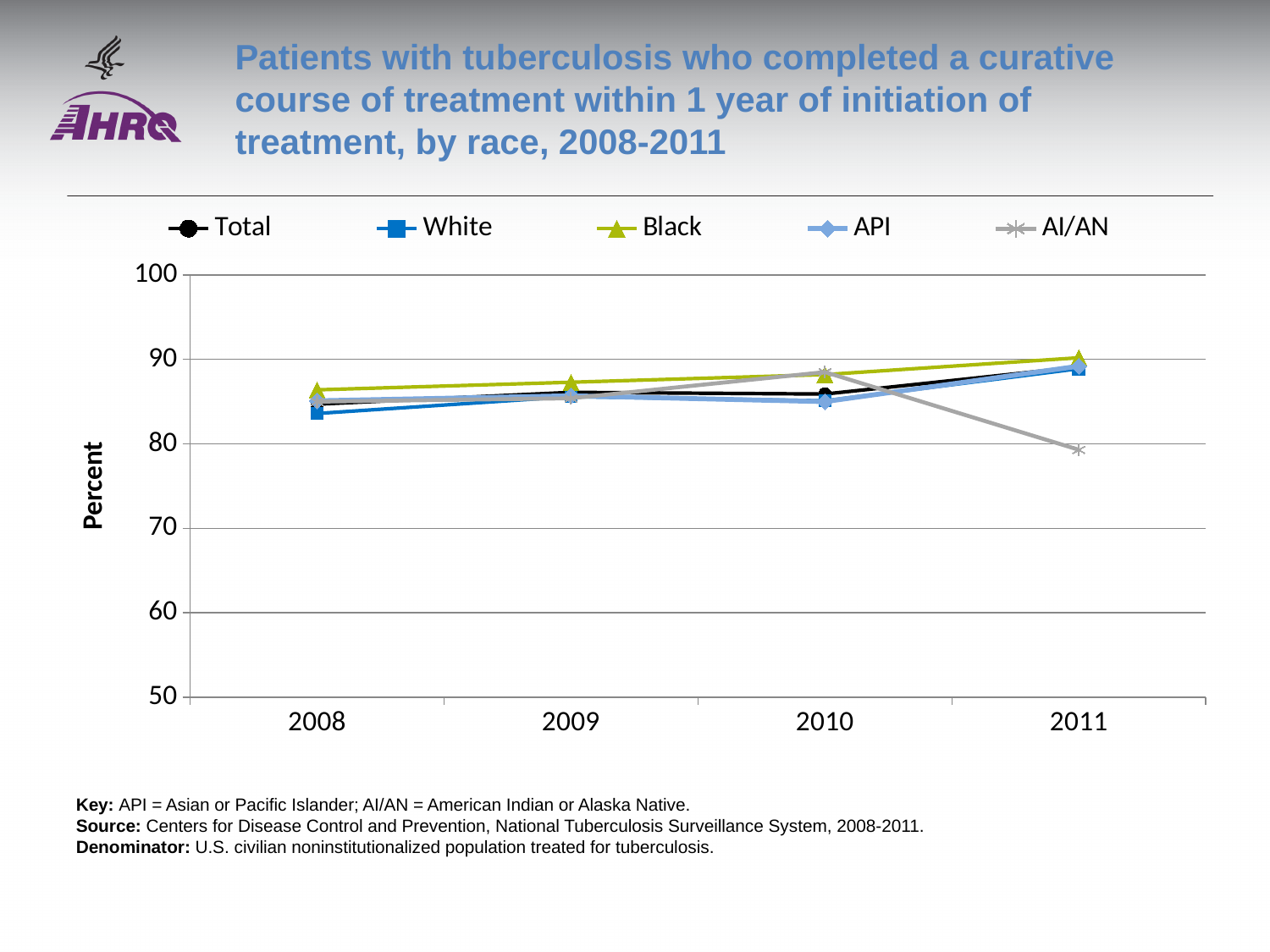
Does the White line rise or fall from 2008 to 2011? rise Is the value for White in 2008 greater or less than 90? less How many series does the legend list? 5 Which series has the lowest value in 2011? AI/AN Which is larger in 2011, the value for Black or the value for AI/AN? Black Does the AI/AN line rise or fall from 2010 to 2011? fall How many years are shown on the x axis? 4 What is the label on the y axis? Percent Is the value for AI/AN in 2010 greater or less than 80? greater Is the value for Black in 2008 greater or less than 80? greater What kind of chart is shown on the slide? line chart